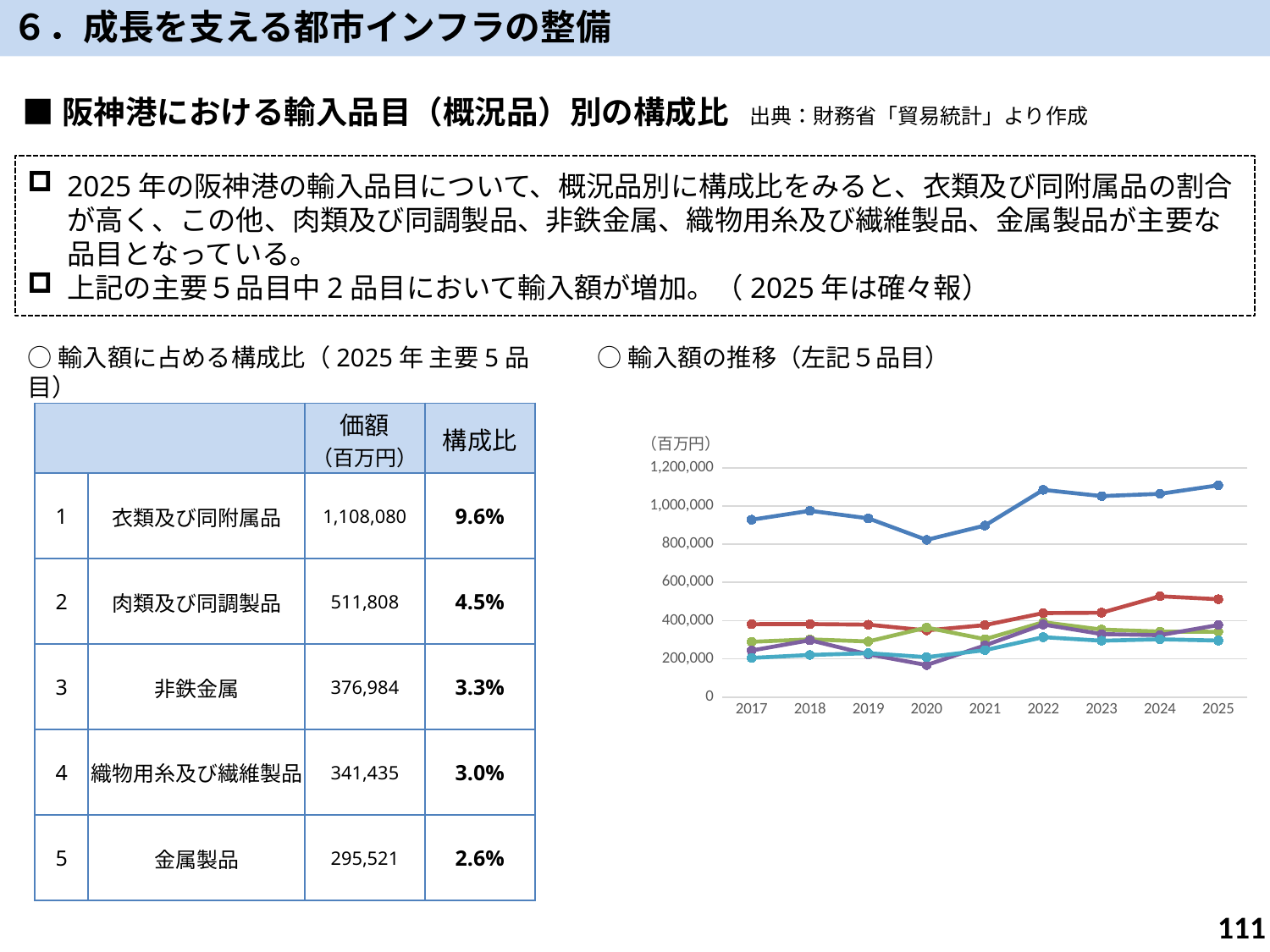
In the 「輸入額の推移」 chart, is the value of the red line in 2024 greater or less than 400,000? greater What is the last year shown on the x axis of the 「輸入額の推移」 chart? 2025 In the 「輸入額の推移」 chart, is the value of the blue line in 2022 greater or less than 1,000,000? greater What kind of chart is shown under 「輸入額の推移（左記5品目）」? line chart What unit is shown above the y axis of the 「輸入額の推移」 chart? 百万円 How many years are plotted on the x axis of the 「輸入額の推移」 chart? 9 In the 「輸入額の推移」 chart, which coloured line has the highest values across all years? the blue line In the 「輸入額の推移」 chart, is the value of the blue line in 2017 greater or less than 1,000,000? less In the 「輸入額の推移」 chart, does the blue line rise or fall between 2020 and 2022? rise What is the first year shown on the x axis of the 「輸入額の推移」 chart? 2017 How many lines are plotted in the 「輸入額の推移」 chart? 5 In the 「輸入額の推移」 chart, in which year is the blue line at its lowest? 2020